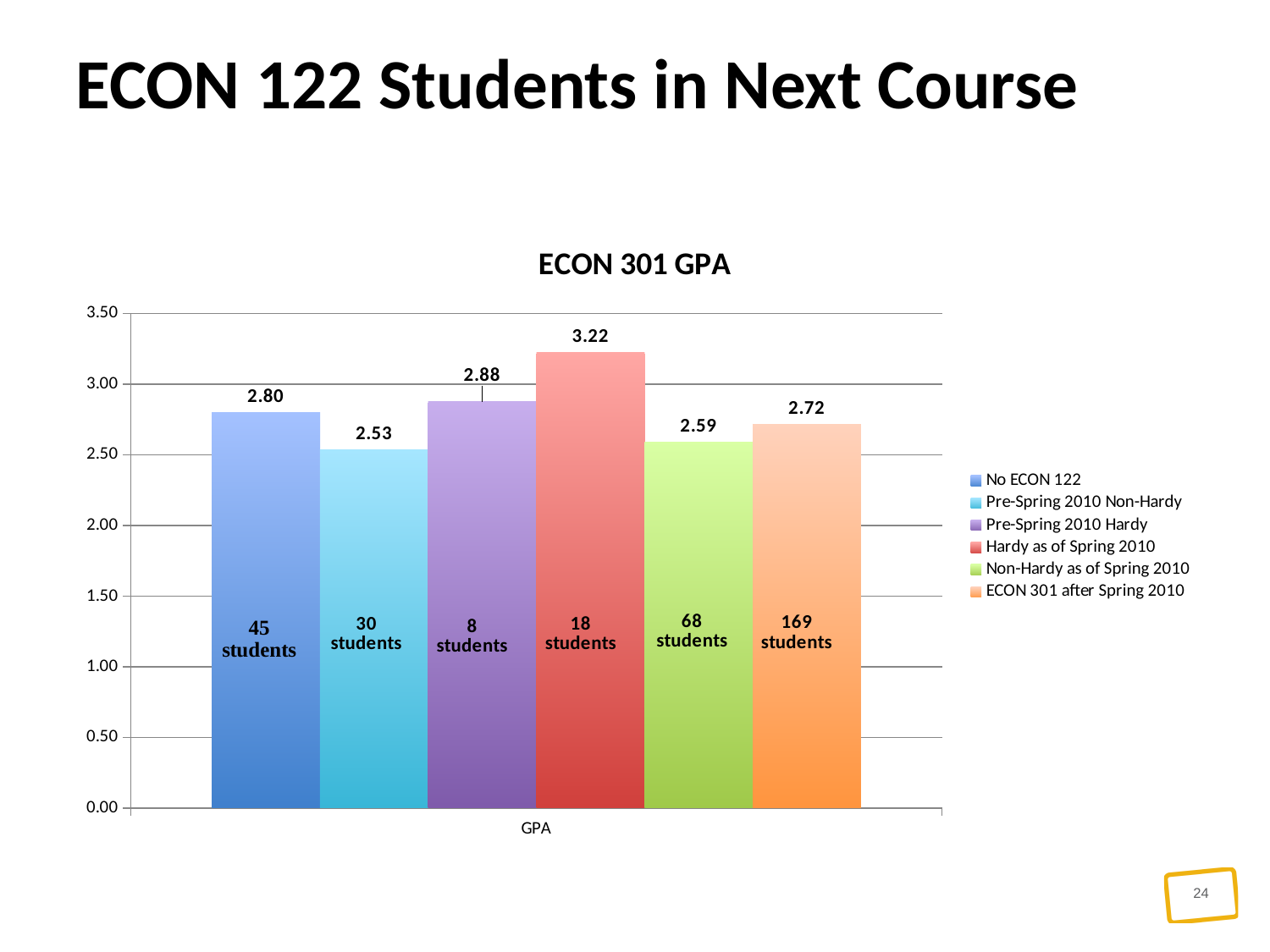
What is the difference in ECON 301 GPA between the Hardy as of Spring 2010 group and the Non-Hardy as of Spring 2010 group? 0.63 Is the ECON 301 GPA for the Non-Hardy as of Spring 2010 group greater or less than 3.00? less Which has a higher ECON 301 GPA: Pre-Spring 2010 Hardy or ECON 301 after Spring 2010? Pre-Spring 2010 Hardy How many series does the legend list? 6 Which group has the lowest ECON 301 GPA? Pre-Spring 2010 Non-Hardy What is the title of the chart? ECON 301 GPA What is the ECON 301 GPA for the Hardy as of Spring 2010 group? 3.22 How many students are in the ECON 301 after Spring 2010 group? 169 students What is the ECON 301 GPA for the Pre-Spring 2010 Non-Hardy group? 2.53 What is the ECON 301 GPA for the No ECON 122 group? 2.80 What kind of chart is shown on the slide? bar chart Which group has the highest ECON 301 GPA? Hardy as of Spring 2010